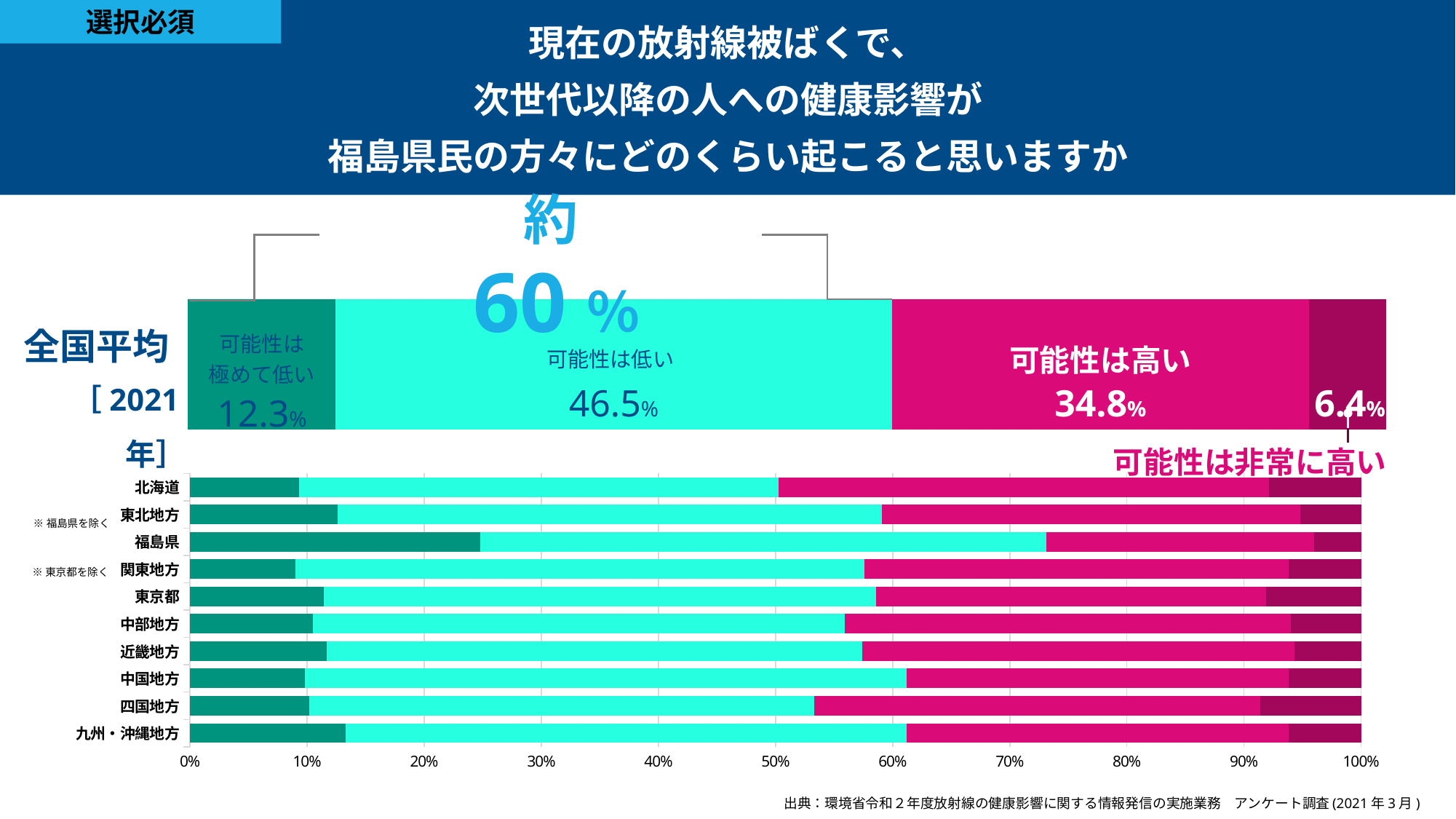
In the regional chart at the bottom, which region has the largest 可能性は極めて低い (dark green) segment? 福島県 In the 全国平均 [2021年] bar, what is the value for 可能性は非常に高い? 6.4% In the 全国平均 [2021年] bar, which response category has the largest share? 可能性は低い In the 全国平均 [2021年] bar, what is the value for 可能性は極めて低い? 12.3% In the regional chart at the bottom, is the 可能性は極めて低い segment for 福島県 greater or less than 20%? greater In the 全国平均 [2021年] bar, how many percentage points larger is 可能性は低い than 可能性は極めて低い? 34.2 In the 全国平均 [2021年] bar, which is larger: 可能性は低い or 可能性は高い? 可能性は低い In the 全国平均 [2021年] bar, which response category has the smallest share? 可能性は非常に高い What kind of chart is the regional chart at the bottom of the slide? Stacked horizontal bar chart In the regional chart at the bottom, how many regions are listed on the vertical axis? 10 In the 全国平均 [2021年] bar, what is the value for 可能性は高い? 34.8% In the 全国平均 [2021年] bar, what is the value for 可能性は低い? 46.5%